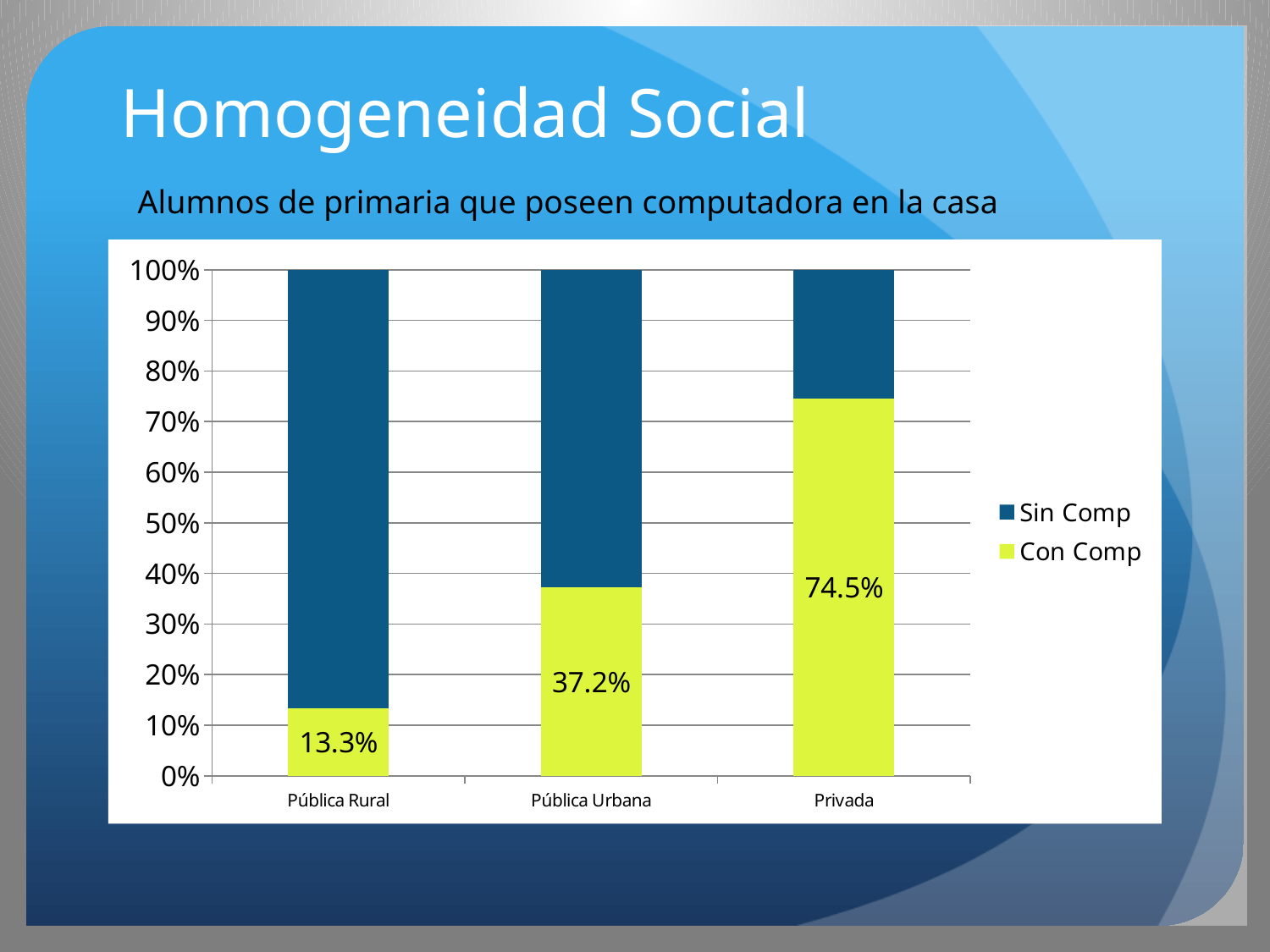
Which category has the lowest Con Comp value? Pública Rural What is the difference between the Con Comp values for Privada and Pública Rural? 61.2% What is the Con Comp value for Pública Rural? 13.3% How many series does the legend list? 2 What is the Con Comp value for Pública Urbana? 37.2% Is the Sin Comp value for Pública Rural greater or less than 80%? greater Which is larger, the Con Comp value for Pública Urbana or for Pública Rural? Pública Urbana What is the Con Comp value for Privada? 74.5% Is the Sin Comp value for Privada greater or less than 30%? less Which category has the highest Con Comp value? Privada How many categories are shown on the x axis? 3 What kind of chart is shown on the slide? Stacked bar chart